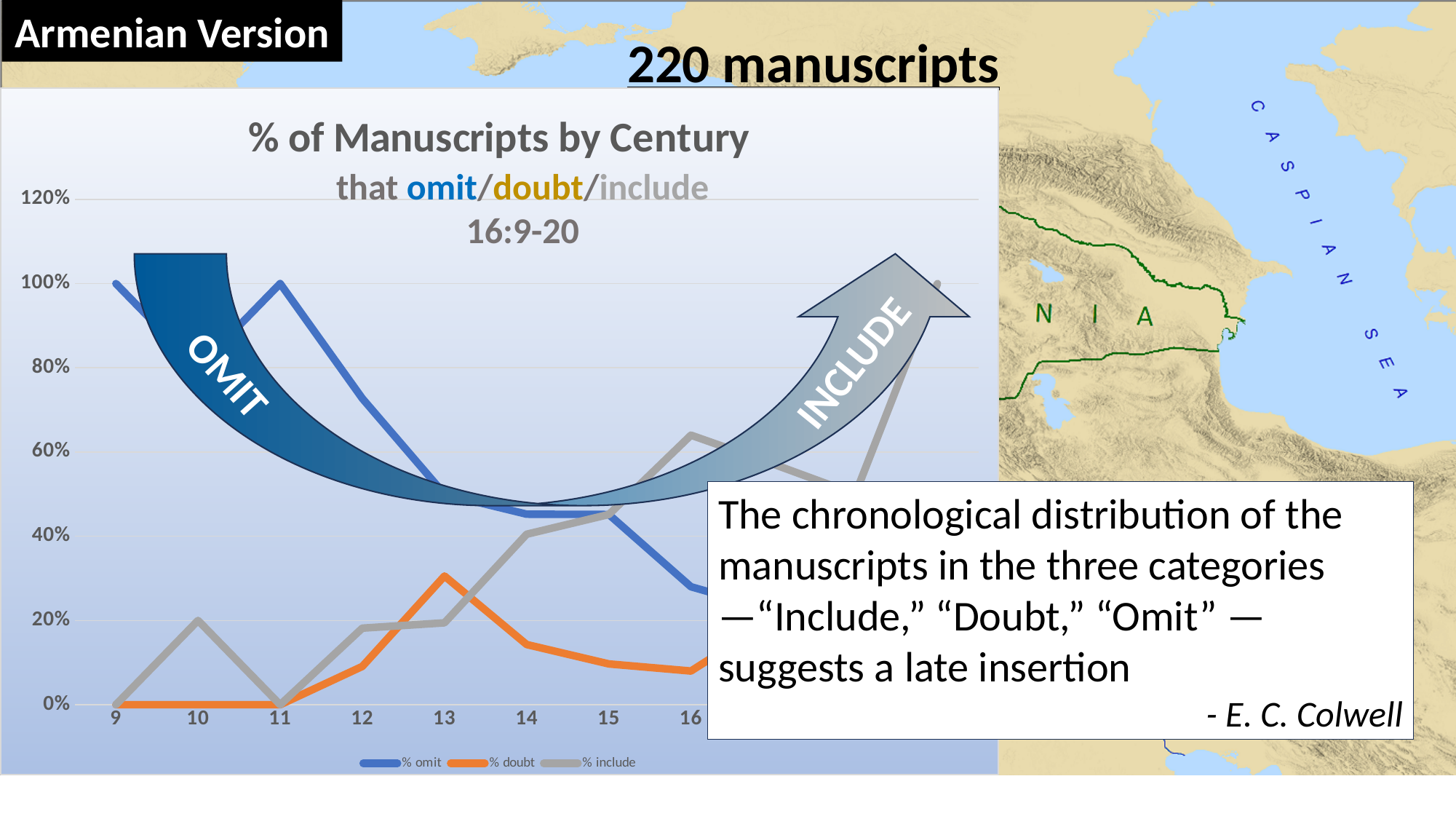
At century 16, which is larger, % include or % omit? % include Does the % omit line rise or fall from century 11 to century 16? fall What colour is the % doubt line in the chart? orange Is the value of % doubt at century 13 greater or less than 20%? greater What is the value of % doubt at century 11? 0% How many series does the chart legend list? 3 Which series has the highest value at century 9? % omit Is the value of % omit at century 16 greater or less than 40%? less What is the value of % include at century 10? 20% What kind of chart is shown on the slide? line chart What is the value of % omit at century 9? 100%